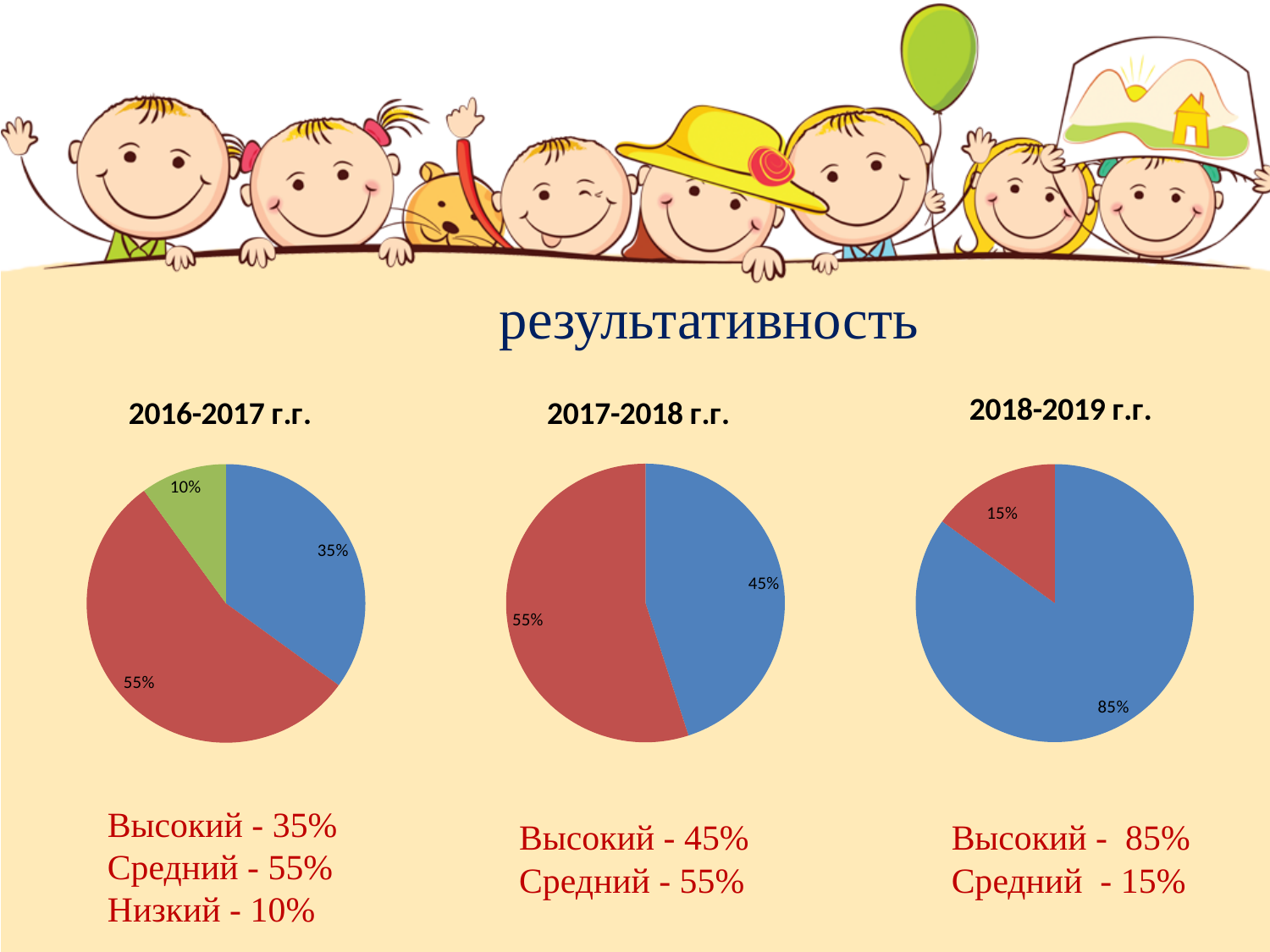
How many slices does the "2016-2017 г.г." pie chart have? 3 How many slices does the "2017-2018 г.г." pie chart have? 2 In the "2017-2018 г.г." pie chart, what is the difference between the "Средний" and "Высокий" shares? 10% In the "2016-2017 г.г." pie chart, what share does the "Высокий" level have? 35% In the "2017-2018 г.г." pie chart, what share does the "Высокий" level have? 45% In the "2018-2019 г.г." pie chart, which is larger, the "Высокий" slice or the "Средний" slice? Высокий In the "2016-2017 г.г." pie chart, which level has the smallest slice? Низкий What kind of chart is shown under the title "2016-2017 г.г."? pie chart In the "2018-2019 г.г." pie chart, what share does the "Средний" level have? 15% In the "2016-2017 г.г." pie chart, which level has the largest slice? Средний Across the three pie charts, does the "Высокий" share rise or fall from 2016-2017 to 2018-2019? rise